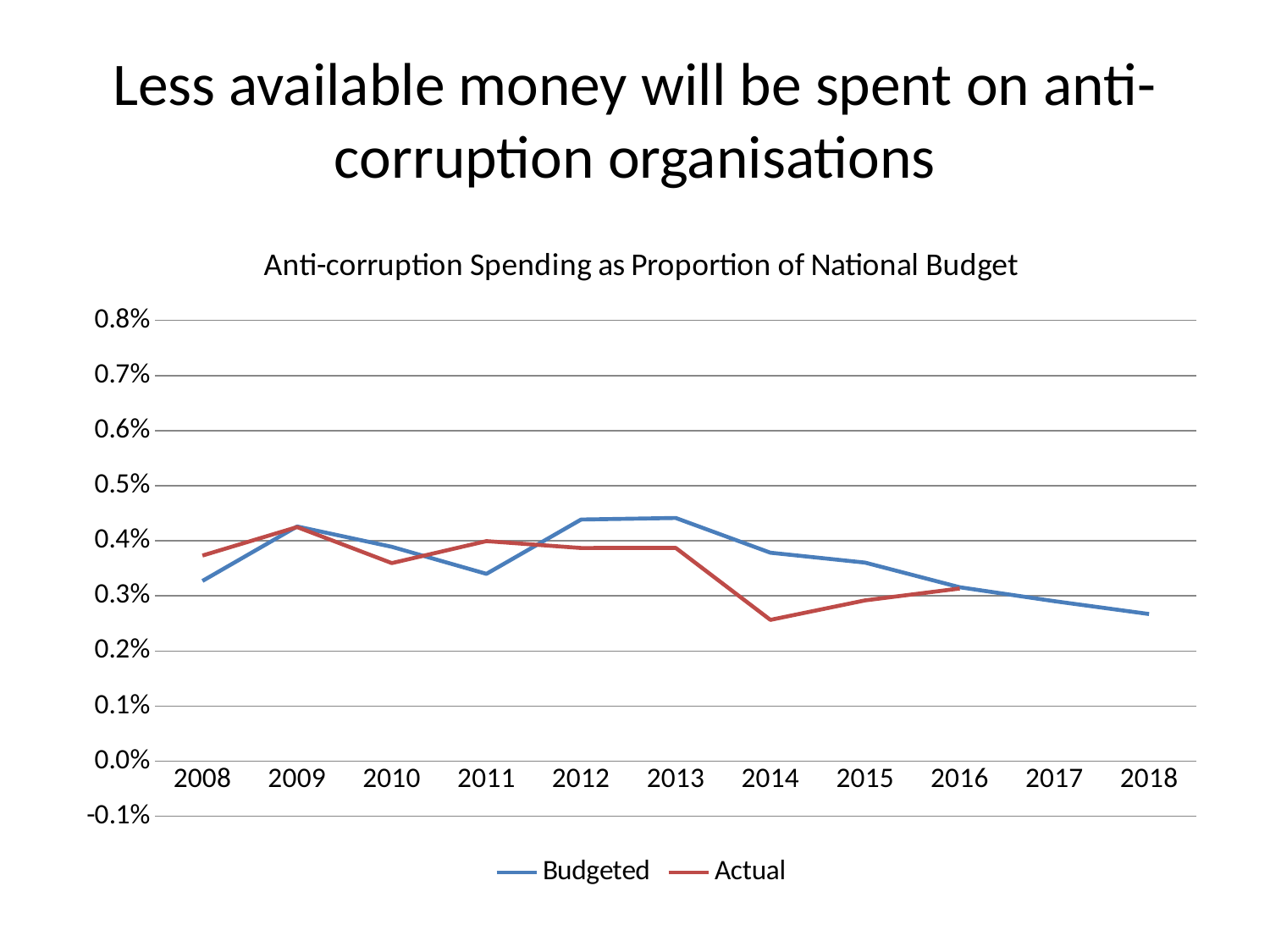
Which series is drawn in red? Actual What is the title of the chart? Anti-corruption Spending as Proportion of National Budget Is the Budgeted value for 2012 greater or less than 0.4%? greater How many years are shown on the x axis? 11 In 2014, which is larger, the Budgeted value or the Actual value? Budgeted Is the Budgeted value for 2018 greater or less than 0.3%? less In 2011, which is larger, the Budgeted value or the Actual value? Actual Is the Actual value for 2014 greater or less than 0.3%? less Does the Budgeted series rise or fall from 2013 to 2018? fall How many series does the legend list? 2 What kind of chart is shown on the slide? line chart In which year is the Actual series at its lowest? 2014